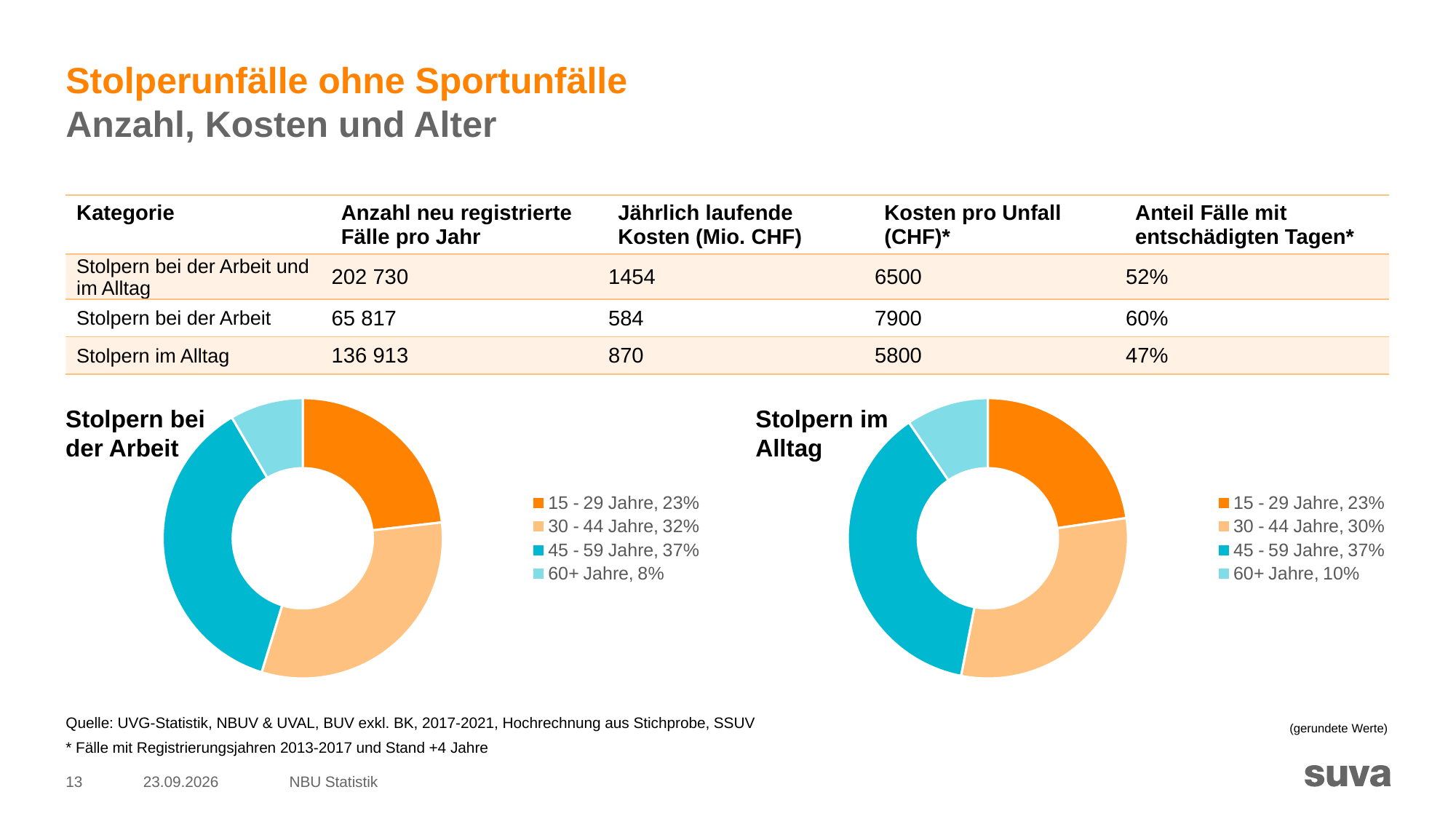
In the 'Stolpern bei der Arbeit' chart, what share of the total do the 60+ Jahre represent? 8% In the 'Stolpern im Alltag' chart, what is the difference between the shares of 30 - 44 Jahre and 60+ Jahre? 20 percentage points What kind of chart is the 'Stolpern im Alltag' chart? Donut (pie) chart How many age groups does the 'Stolpern bei der Arbeit' chart show? 4 What is the title of the donut chart on the left side of the slide? Stolpern bei der Arbeit In the 'Stolpern im Alltag' chart, what share do the 60+ Jahre have? 10% In the 'Stolpern bei der Arbeit' chart, what share do the 30 - 44 Jahre have? 32% In the 'Stolpern im Alltag' chart, which age group has the smallest share? 60+ Jahre In the 'Stolpern bei der Arbeit' chart, which age group has the largest share? 45 - 59 Jahre In the 'Stolpern im Alltag' chart, which colour represents the 45 - 59 Jahre group? Teal (dark turquoise) In the 'Stolpern bei der Arbeit' chart, what is the difference between the shares of 45 - 59 Jahre and 15 - 29 Jahre? 14 percentage points In the 'Stolpern im Alltag' chart, which is larger: the share of 30 - 44 Jahre or the share of 15 - 29 Jahre? 30 - 44 Jahre